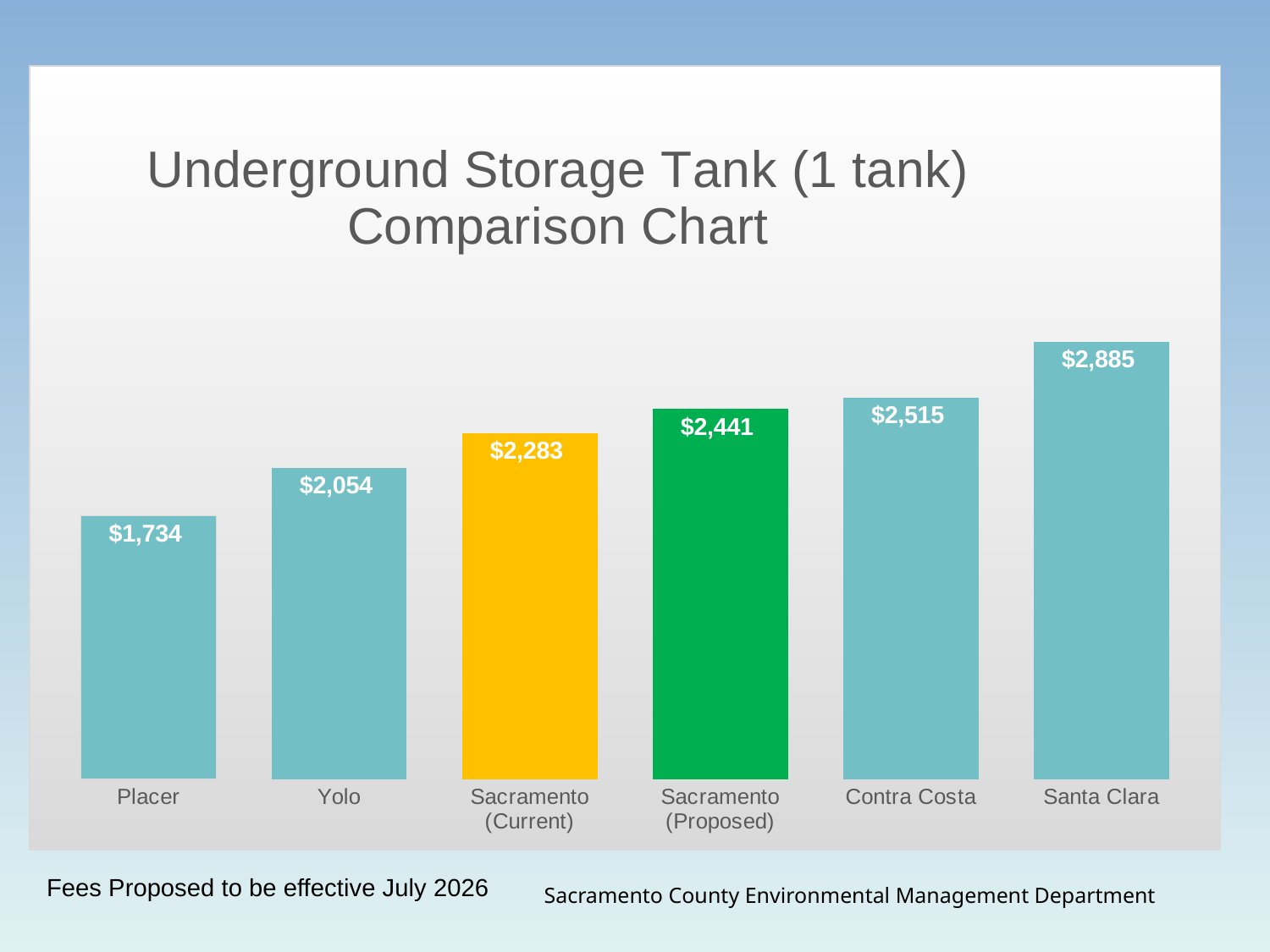
Which category has the highest value? Santa Clara What is the value for Placer? $1,734 What is the value for Contra Costa? $2,515 Which is larger, the value for Yolo or the value for Contra Costa? Contra Costa What kind of chart is this? Bar chart What is the value for Sacramento (Proposed)? $2,441 Which category has the lowest value? Placer What is the difference between Sacramento (Proposed) and Sacramento (Current)? $158 Do the values rise or fall from left to right across the categories? Rise How many categories are shown in the chart? 6 What is the difference between Santa Clara and Placer? $1,151 What is the title of the chart? Underground Storage Tank (1 tank) Comparison Chart